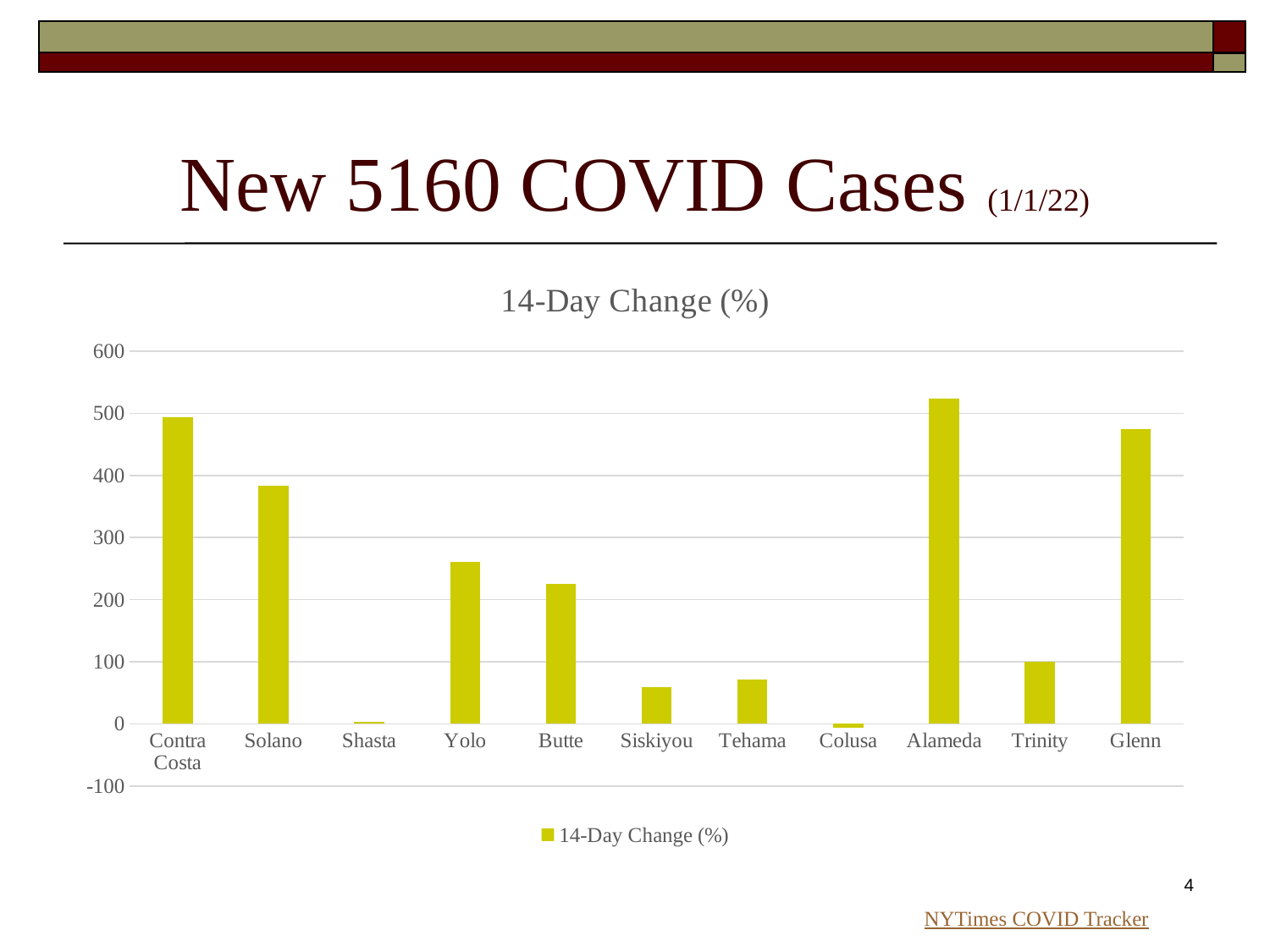
Is the value for Butte greater or less than 300? less How many series does the chart's legend list? 1 Is the value for Siskiyou greater or less than 100? less Is the value for Yolo greater or less than 200? greater Which county has the highest 14-day change (%)? Alameda What kind of chart is shown on the slide? bar chart Which has the larger 14-day change, Butte or Tehama? Butte Which has the larger 14-day change, Solano or Yolo? Solano What is the title of the chart? 14-Day Change (%) How many counties are shown on the x axis of the chart? 11